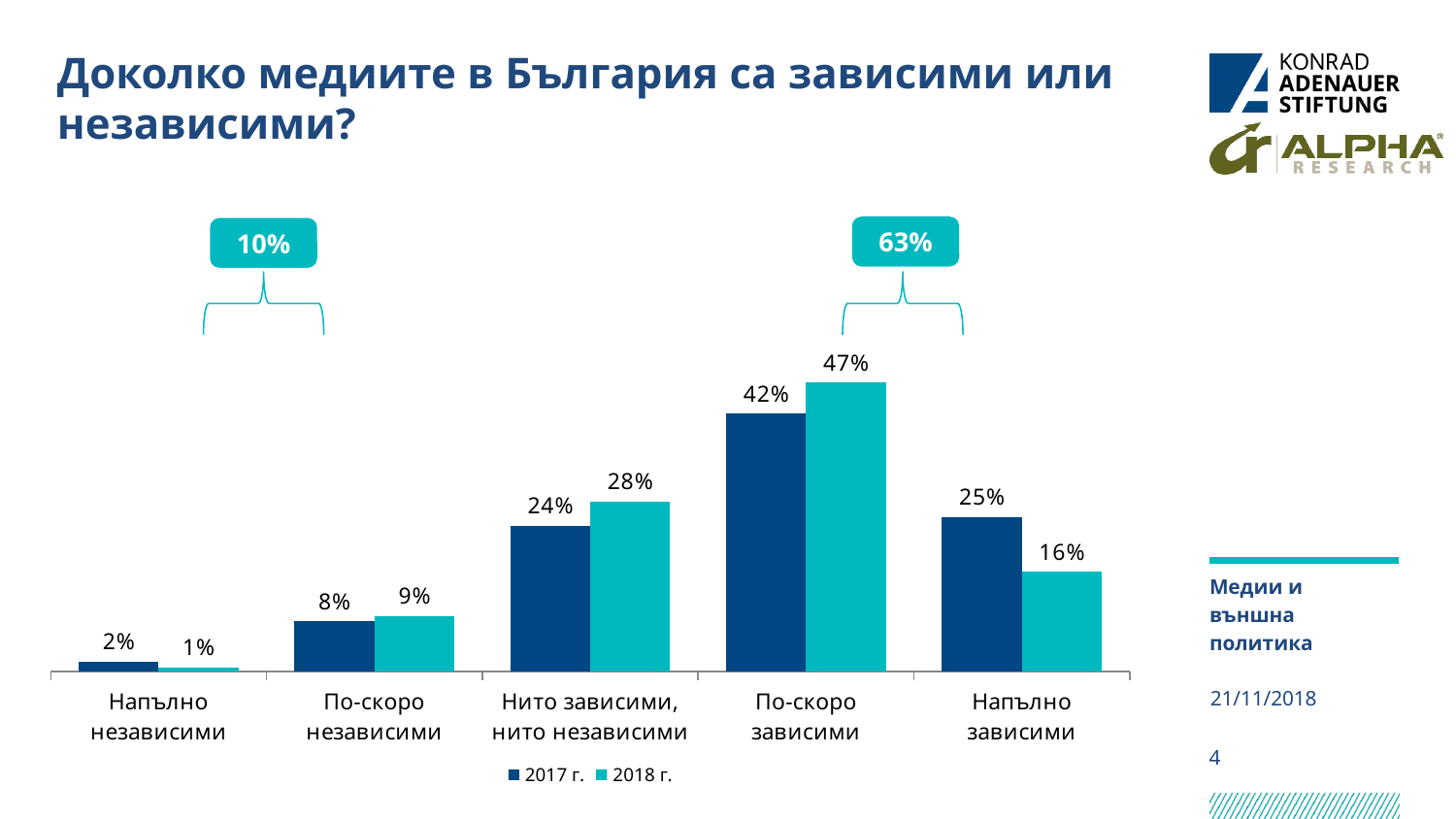
What is the difference between the 2018 г. and 2017 г. values for "Напълно зависими"? 9% Which is larger for "Нито зависими, нито независими": the 2017 г. value or the 2018 г. value? 2018 г. What is the value for "По-скоро зависими" in the 2018 г. series? 47% What percentage is shown in the callout above the "По-скоро зависими" and "Напълно зависими" bars? 63% What kind of chart is shown on the slide? Bar chart Which category has the highest value in the 2018 г. series? По-скоро зависими What is the value for "Напълно независими" in the 2017 г. series? 2% How many series does the legend list? 2 Which category has the lowest value in the 2017 г. series? Напълно независими What is the value for "Нито зависими, нито независими" in the 2018 г. series? 28% How many categories are shown on the x axis? 5 What is the value for "Напълно зависими" in the 2017 г. series? 25%